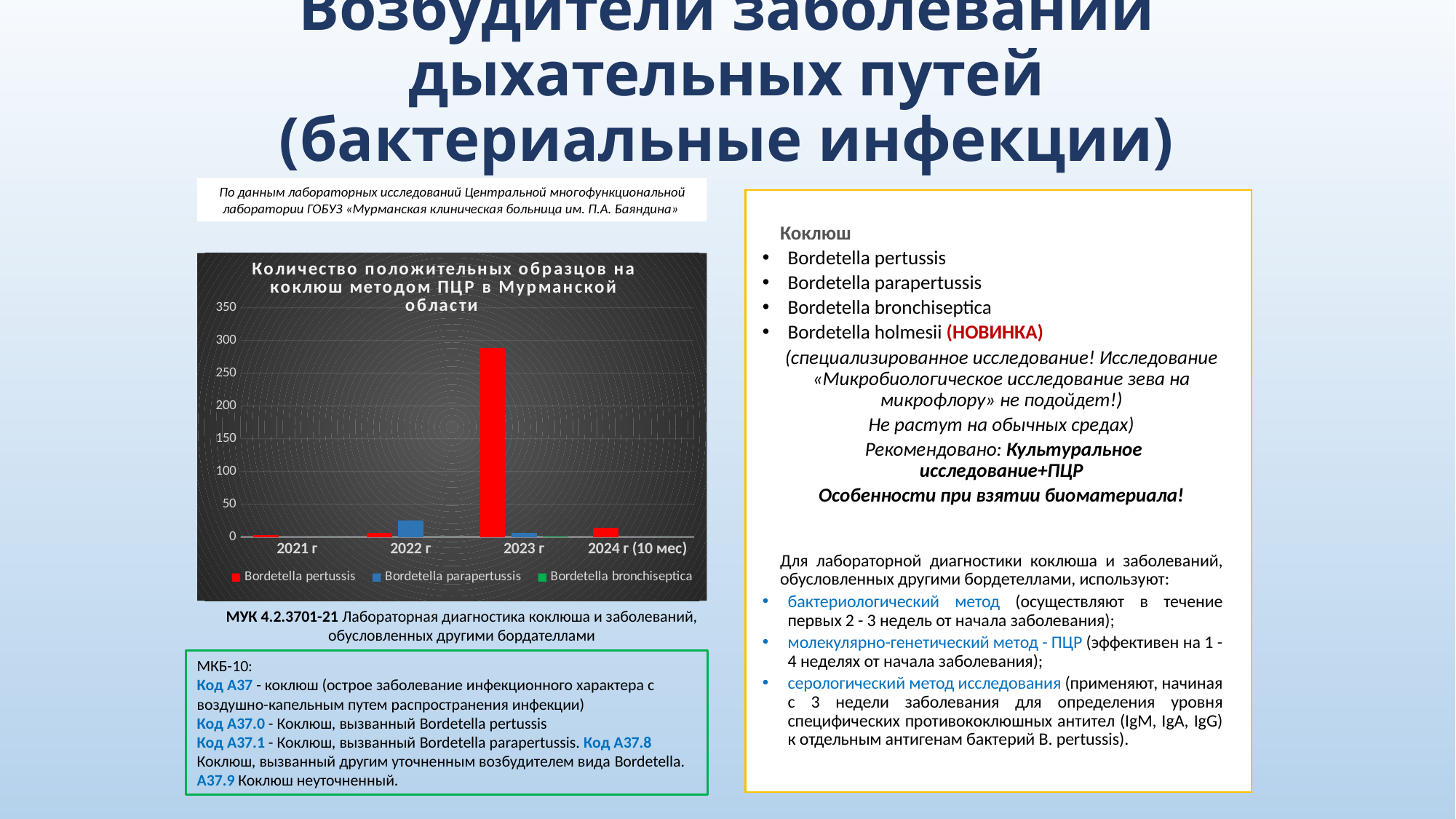
In 2022 г, which is larger: Bordetella pertussis or Bordetella parapertussis? Bordetella parapertussis Is the value for Bordetella pertussis in 2023 г greater or less than 250? greater Which colour represents Bordetella pertussis in the chart? red Is the value for Bordetella pertussis in 2023 г greater or less than 300? less How many series does the chart legend list? 3 Is the value for Bordetella pertussis in 2024 г (10 мес) greater or less than 50? less How many year categories are shown on the x axis of the chart? 4 In which year is the value for Bordetella pertussis highest? 2023 г What is the title of the chart? Количество положительных образцов на коклюш методом ПЦР в Мурманской области What kind of chart is shown on the slide? bar chart Which is larger: Bordetella pertussis in 2023 г or Bordetella parapertussis in 2022 г? Bordetella pertussis in 2023 г